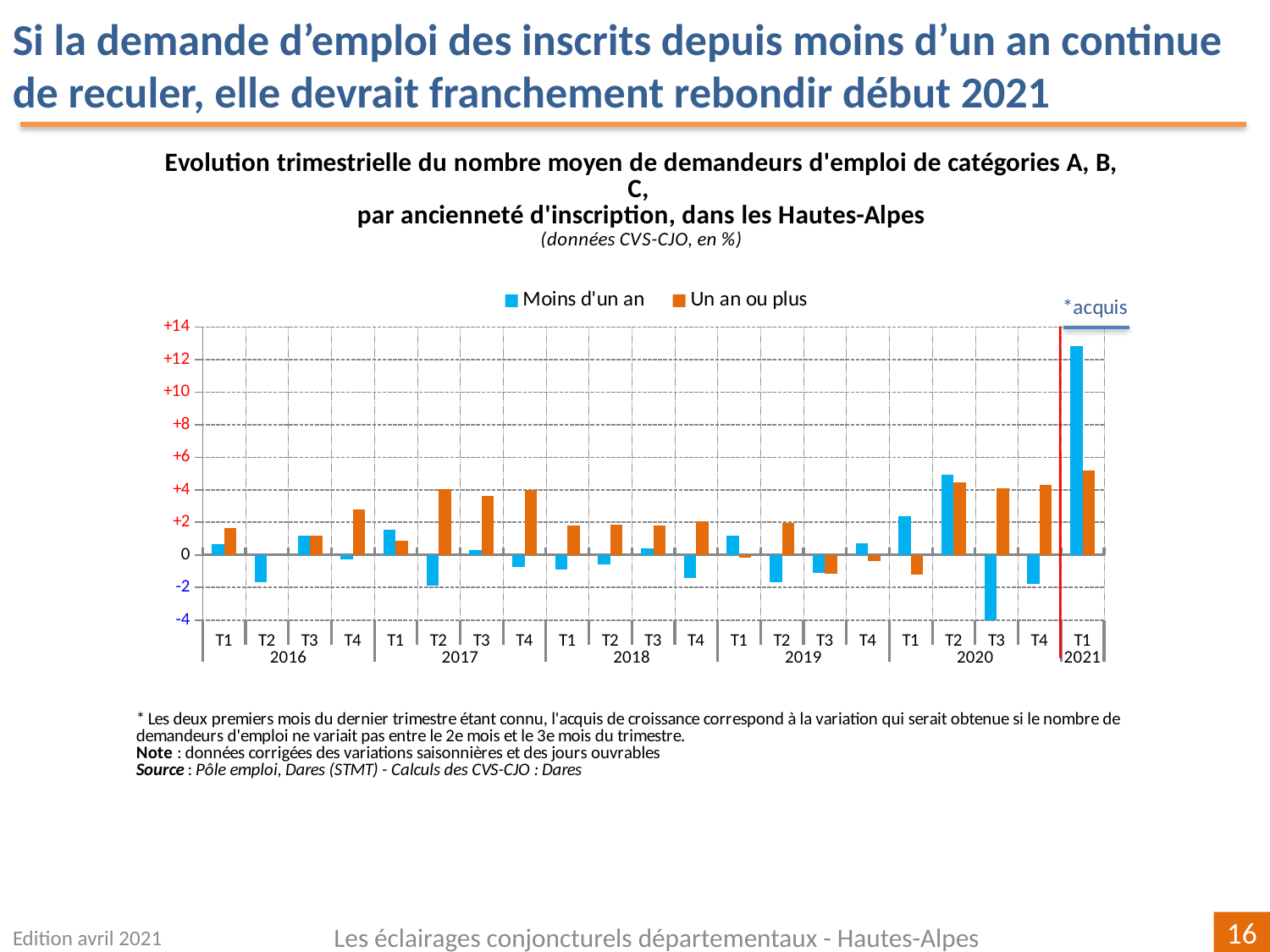
In which quarter is the value for 'Moins d'un an' the highest? T1 2021 What kind of chart is shown on the slide? Bar chart Is the value for 'Un an ou plus' in T2 2017 greater or less than +2? greater What label is attached to the last quarter (T1 2021), marked with an asterisk and a red vertical line? acquis Is the value for 'Moins d'un an' in T3 2020 greater or less than -2? less How many quarters are shown on the x axis? 21 Is the value for 'Moins d'un an' in T1 2021 greater or less than +10? greater In which quarter is the value for 'Moins d'un an' the lowest? T3 2020 What are the two series named in the legend? Moins d'un an; Un an ou plus In T1 2021, which series has the larger value, 'Moins d'un an' or 'Un an ou plus'? Moins d'un an In T2 2017, which series has the larger value, 'Moins d'un an' or 'Un an ou plus'? Un an ou plus How many series does the legend list? 2